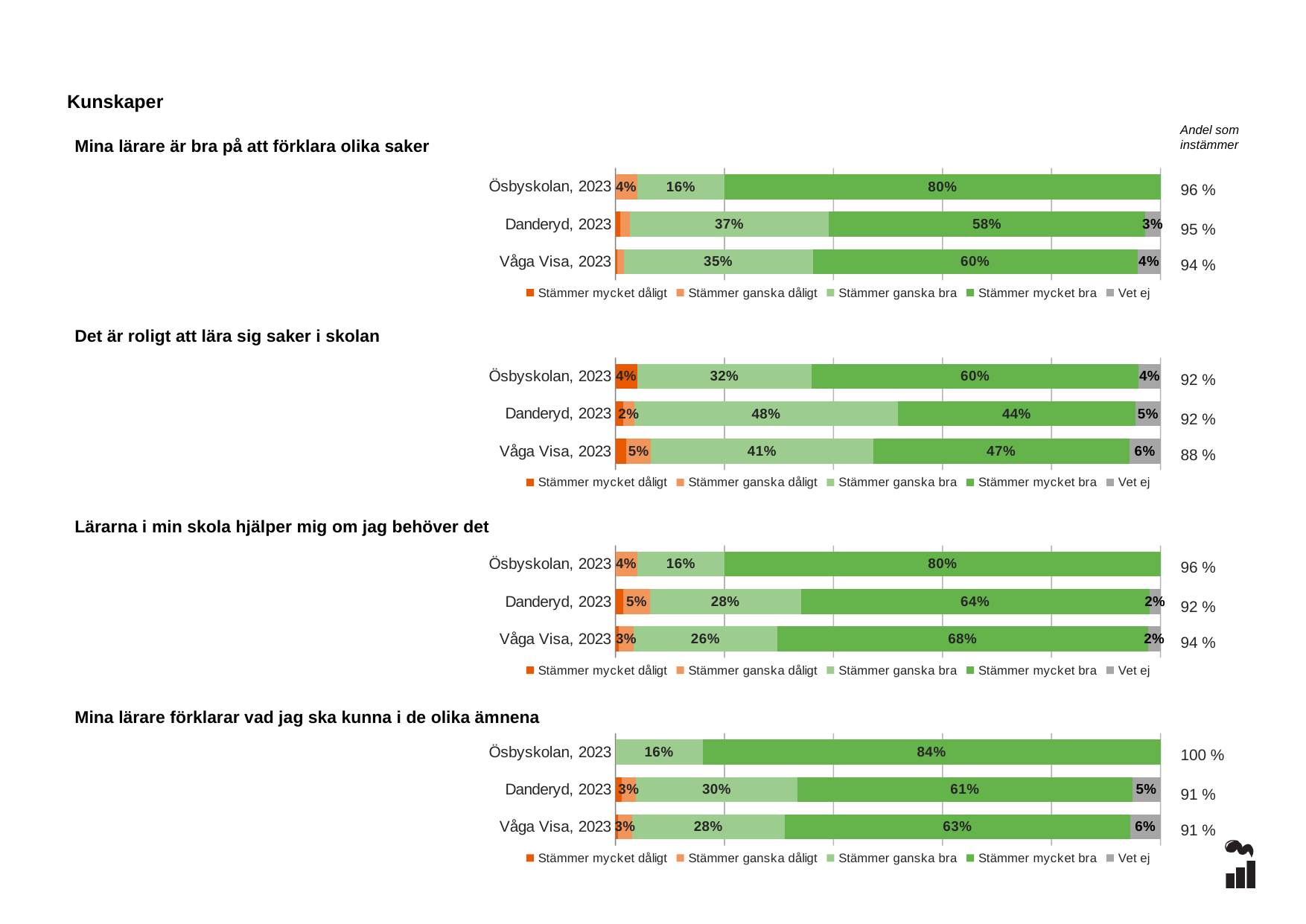
In the chart 'Mina lärare är bra på att förklara olika saker', what is the 'Stämmer ganska bra' value for Danderyd, 2023? 37% In the chart 'Det är roligt att lära sig saker i skolan', which row has the highest 'Stämmer ganska bra' value? Danderyd, 2023 How many series does the legend list for the chart 'Mina lärare förklarar vad jag ska kunna i de olika ämnena'? 5 How many rows (categories) are shown in the chart 'Det är roligt att lära sig saker i skolan'? 3 What kind of chart is 'Lärarna i min skola hjälper mig om jag behöver det'? Stacked bar chart In the chart 'Lärarna i min skola hjälper mig om jag behöver det', what is the 'Stämmer ganska dåligt' value for Danderyd, 2023? 5% In the chart 'Det är roligt att lära sig saker i skolan', what is the 'Vet ej' value for Våga Visa, 2023? 6% In the chart 'Mina lärare förklarar vad jag ska kunna i de olika ämnena', what is the 'Stämmer mycket bra' value for Ösbyskolan, 2023? 84% In the chart 'Mina lärare är bra på att förklara olika saker', what is the 'Stämmer mycket bra' value for Ösbyskolan, 2023? 80% In the chart 'Mina lärare förklarar vad jag ska kunna i de olika ämnena', what is the 'Andel som instämmer' value for Ösbyskolan, 2023? 100 % In the chart 'Det är roligt att lära sig saker i skolan', what is the difference between the 'Stämmer mycket bra' values for Ösbyskolan, 2023 and Våga Visa, 2023? 13% In the chart 'Lärarna i min skola hjälper mig om jag behöver det', which is larger: the 'Stämmer mycket bra' value for Danderyd, 2023 or for Våga Visa, 2023? Våga Visa, 2023